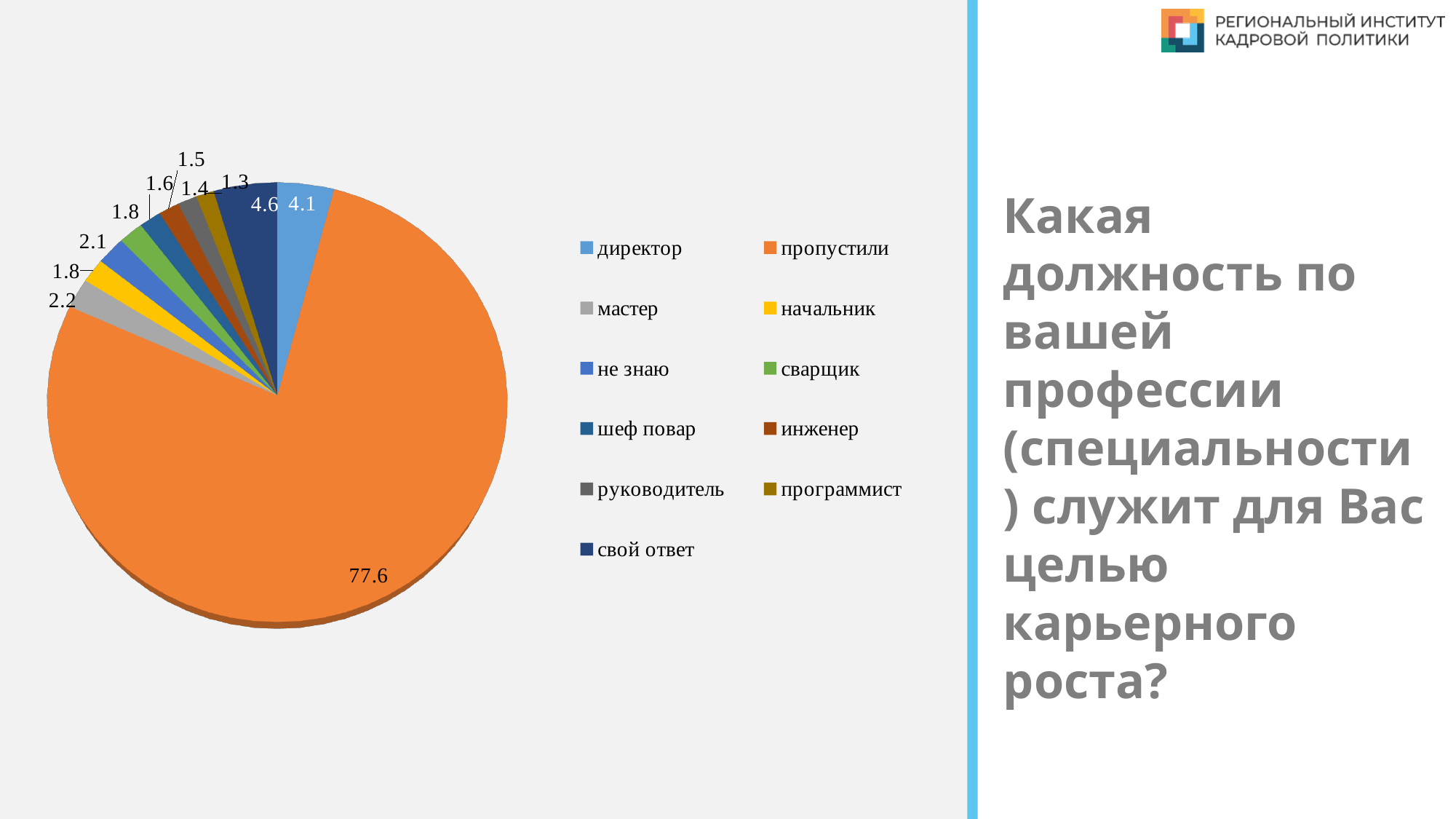
Which category has the smallest slice in the pie chart? программист What colour is the slice for пропустили? orange What is the value for свой ответ in the pie chart? 4.6 What is the value for пропустили in the pie chart? 77.6 What kind of chart is shown on the slide? pie chart Which is larger, the value for мастер or the value for не знаю? мастер What is the difference between the values for свой ответ and директор? 0.5 How many categories does the legend of the pie chart list? 11 Which category has the largest slice in the pie chart? пропустили What is the value for не знаю in the pie chart? 2.1 What is the value for директор in the pie chart? 4.1 What is the value for мастер in the pie chart? 2.2